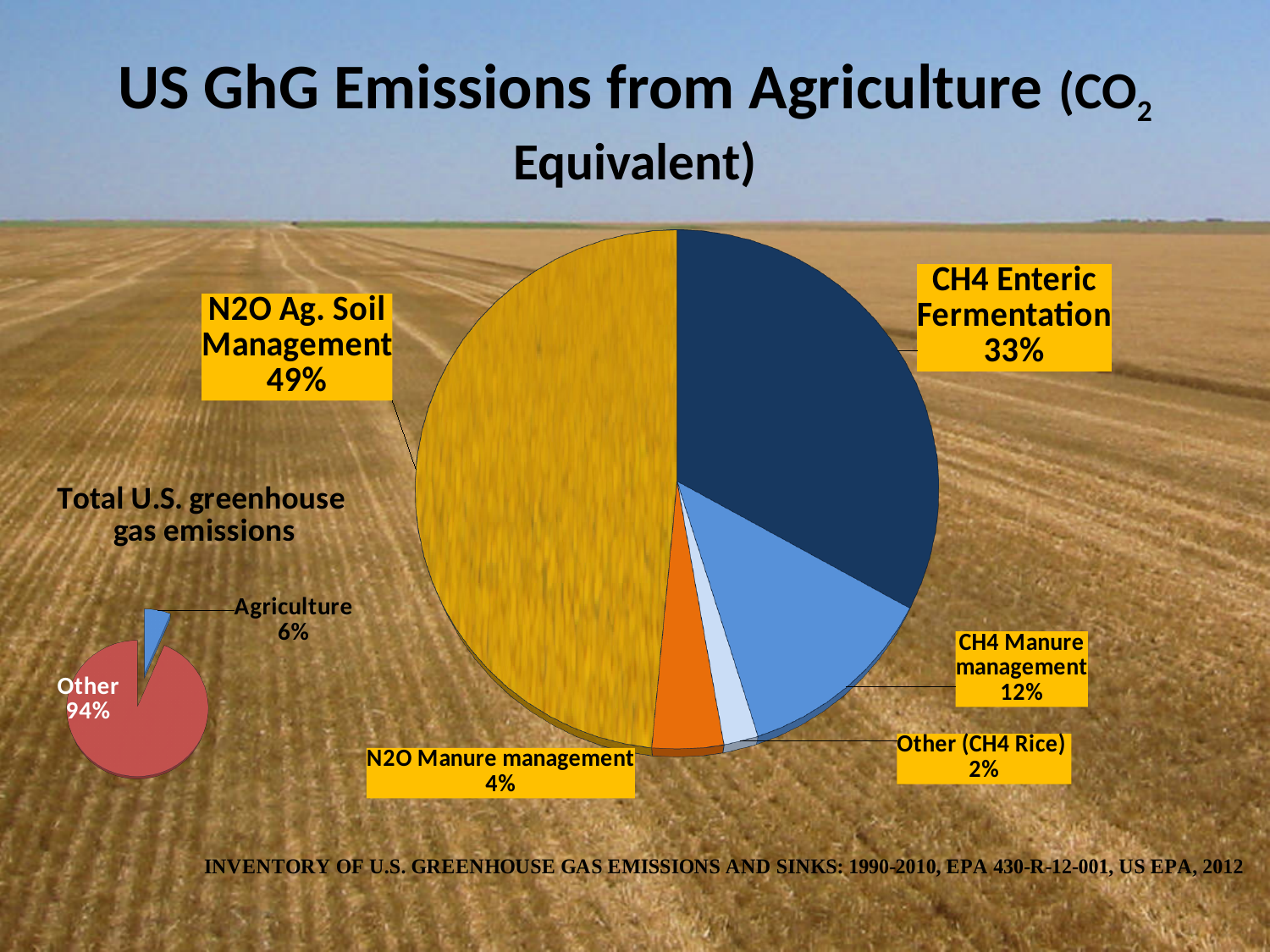
In the large pie chart on US GhG emissions from agriculture, how many percentage points larger is N2O Ag. Soil Management than CH4 Enteric Fermentation? 16 In the large pie chart on US GhG emissions from agriculture, what share is CH4 Manure management? 12% What type of chart is the large chart on US GhG emissions from agriculture? Pie chart In the large pie chart on US GhG emissions from agriculture, what share is CH4 Enteric Fermentation? 33% In the large pie chart on US GhG emissions from agriculture, what share is Other (CH4 Rice)? 2% In the small pie chart titled Total U.S. greenhouse gas emissions, what share is Other? 94% In the large pie chart on US GhG emissions from agriculture, which category has the smallest share? Other (CH4 Rice) In the small pie chart titled Total U.S. greenhouse gas emissions, what share is Agriculture? 6% In the large pie chart on US GhG emissions from agriculture, which is larger: CH4 Manure management or N2O Manure management? CH4 Manure management In the large pie chart on US GhG emissions from agriculture, what share is N2O Ag. Soil Management? 49% In the large pie chart on US GhG emissions from agriculture, which category has the largest share? N2O Ag. Soil Management How many slices does the large pie chart on US GhG emissions from agriculture have? 5